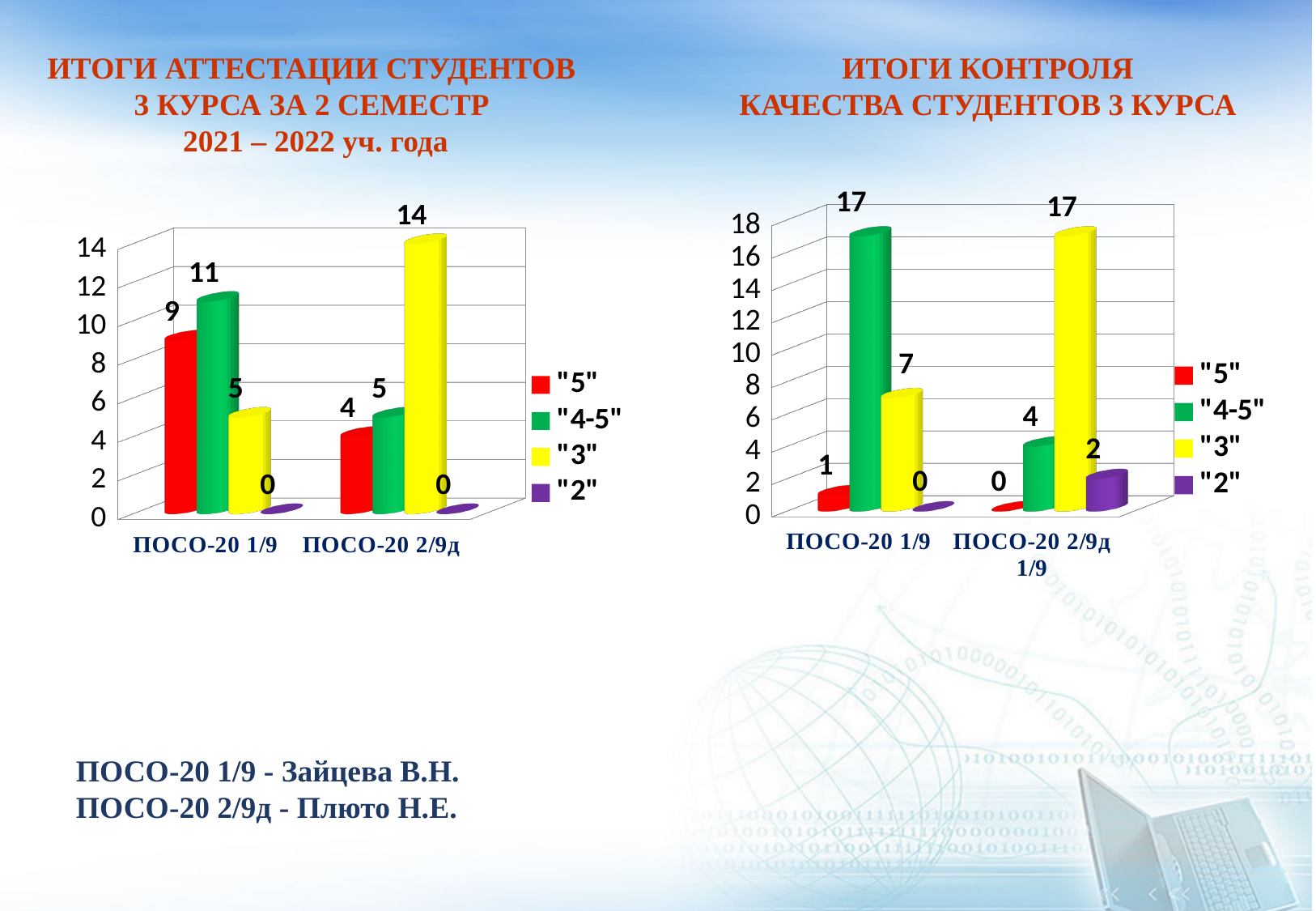
In the left chart (ИТОГИ АТТЕСТАЦИИ СТУДЕНТОВ 3 КУРСА ЗА 2 СЕМЕСТР), what type of chart is shown? Bar chart In the right chart (ИТОГИ КОНТРОЛЯ КАЧЕСТВА СТУДЕНТОВ 3 КУРСА), how many categories are shown on the x axis? 2 In the left chart (ИТОГИ АТТЕСТАЦИИ СТУДЕНТОВ 3 КУРСА ЗА 2 СЕМЕСТР), what is the value of the "4-5" series for ПОСО-20 1/9? 11 In the right chart (ИТОГИ КОНТРОЛЯ КАЧЕСТВА СТУДЕНТОВ 3 КУРСА), what is the difference between the "3" values for ПОСО-20 2/9д and ПОСО-20 1/9? 10 In the left chart (ИТОГИ АТТЕСТАЦИИ СТУДЕНТОВ 3 КУРСА ЗА 2 СЕМЕСТР), what is the difference between the "5" values for ПОСО-20 1/9 and ПОСО-20 2/9д? 5 In the right chart (ИТОГИ КОНТРОЛЯ КАЧЕСТВА СТУДЕНТОВ 3 КУРСА), what is the value of the "4-5" series for ПОСО-20 1/9? 17 In the left chart (ИТОГИ АТТЕСТАЦИИ СТУДЕНТОВ 3 КУРСА ЗА 2 СЕМЕСТР), what is the value of the "3" series for ПОСО-20 2/9д? 14 In the right chart (ИТОГИ КОНТРОЛЯ КАЧЕСТВА СТУДЕНТОВ 3 КУРСА), what is the value of the "2" series for ПОСО-20 2/9д? 2 In the left chart (ИТОГИ АТТЕСТАЦИИ СТУДЕНТОВ 3 КУРСА ЗА 2 СЕМЕСТР), how many series does the legend list? 4 In the left chart (ИТОГИ АТТЕСТАЦИИ СТУДЕНТОВ 3 КУРСА ЗА 2 СЕМЕСТР), which series has the highest value for ПОСО-20 1/9? "4-5" In the right chart (ИТОГИ КОНТРОЛЯ КАЧЕСТВА СТУДЕНТОВ 3 КУРСА), which series has the highest value for ПОСО-20 2/9д? "3" In the right chart (ИТОГИ КОНТРОЛЯ КАЧЕСТВА СТУДЕНТОВ 3 КУРСА), which is larger: the "3" value for ПОСО-20 1/9 or the "4-5" value for ПОСО-20 2/9д? The "3" value for ПОСО-20 1/9